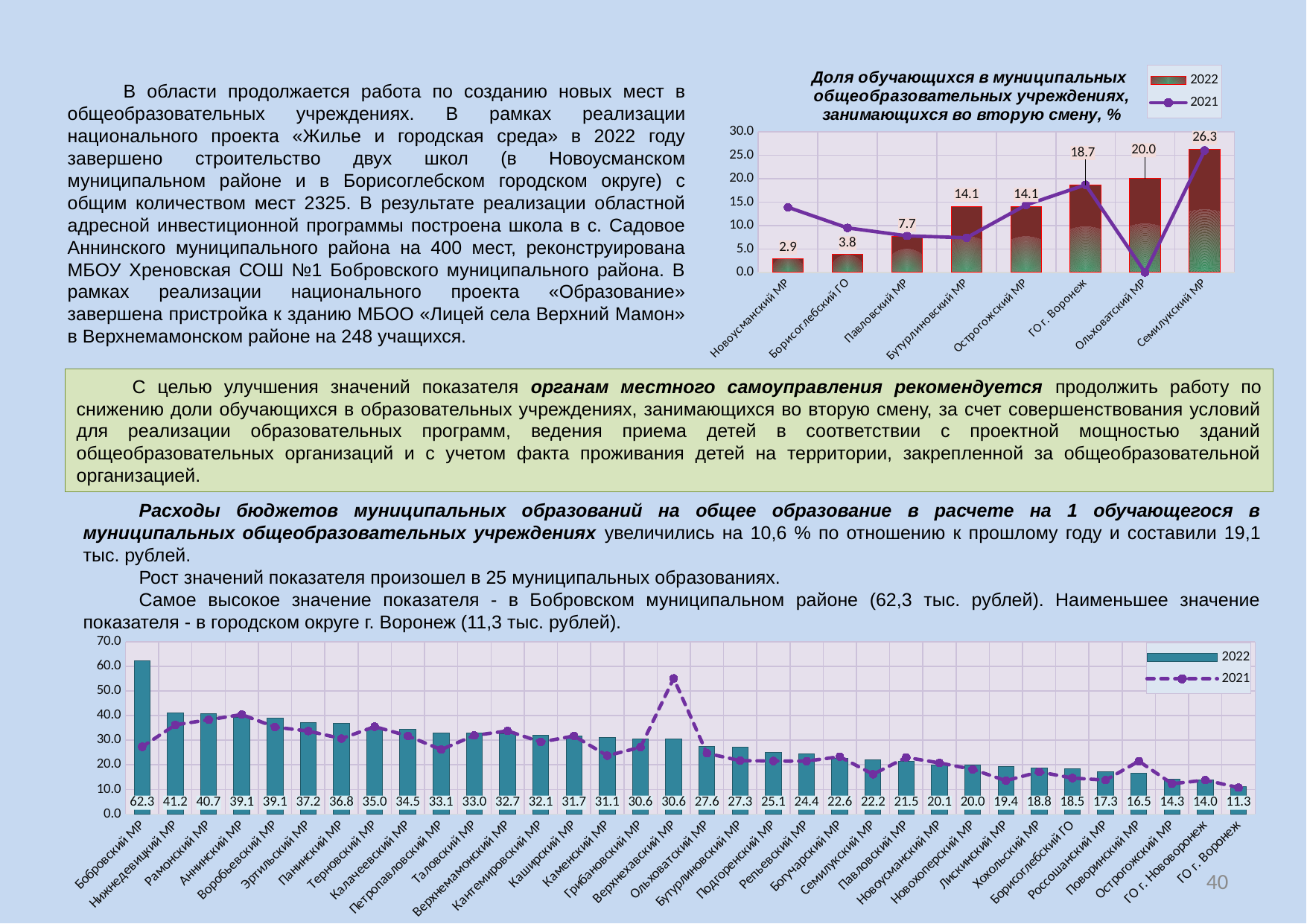
In the top-right chart 'Доля обучающихся ... во вторую смену, %', which category has the lowest 2022 value? Новоусманский МР In the bottom chart, what is the difference between the 2022 values for Бобровский МР and ГО г. Воронеж? 51.0 What kind of chart is the bottom chart? Bar chart with a line series In the bottom chart, which is larger for 2022: Рамонский МР or Эртильский МР? Рамонский МР In the top-right chart 'Доля обучающихся ... во вторую смену, %', how many series does the legend list? 2 In the top-right chart 'Доля обучающихся в муниципальных общеобразовательных учреждениях, занимающихся во вторую смену, %', what is the 2022 value for Семилукский МР? 26.3 In the bottom chart, is the 2021 value for Верхнехавский МР greater or less than 50.0? greater In the top-right chart 'Доля обучающихся ... во вторую смену, %', is the 2021 value for Ольховатский МР greater or less than 5.0? less In the top-right chart 'Доля обучающихся ... во вторую смену, %', what is the difference between the 2022 values for Ольховатский МР and Павловский МР? 12.3 In the bottom chart, what is the 2022 value for Бобровский МР? 62.3 In the top-right chart 'Доля обучающихся ... во вторую смену, %', how many categories are shown on the x axis? 8 In the bottom chart, which category has the lowest 2022 value? ГО г. Воронеж